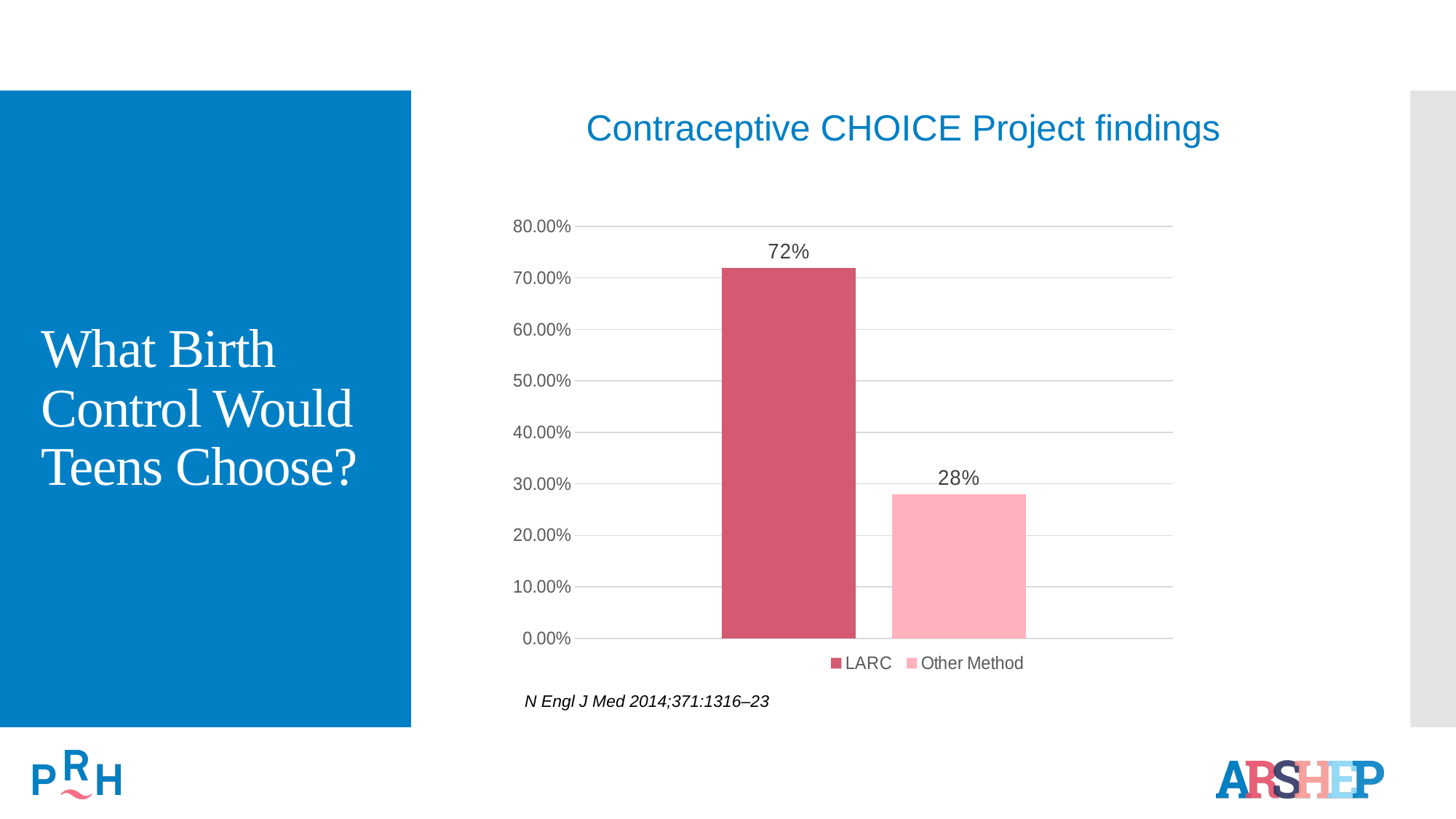
How many bars are plotted in the chart? 2 What is the value for Other Method? 28% Which is larger, the value for LARC or the value for Other Method? LARC Which series has the highest value? LARC What is the title of the chart? Contraceptive CHOICE Project findings Which series has the lowest value? Other Method What is the difference between the LARC value and the Other Method value? 44% What is the value for LARC? 72% What kind of chart is shown on the slide? Bar chart Is the value for LARC greater or less than 70.00%? greater How many series does the legend list? 2 Is the value for Other Method greater or less than 30.00%? less